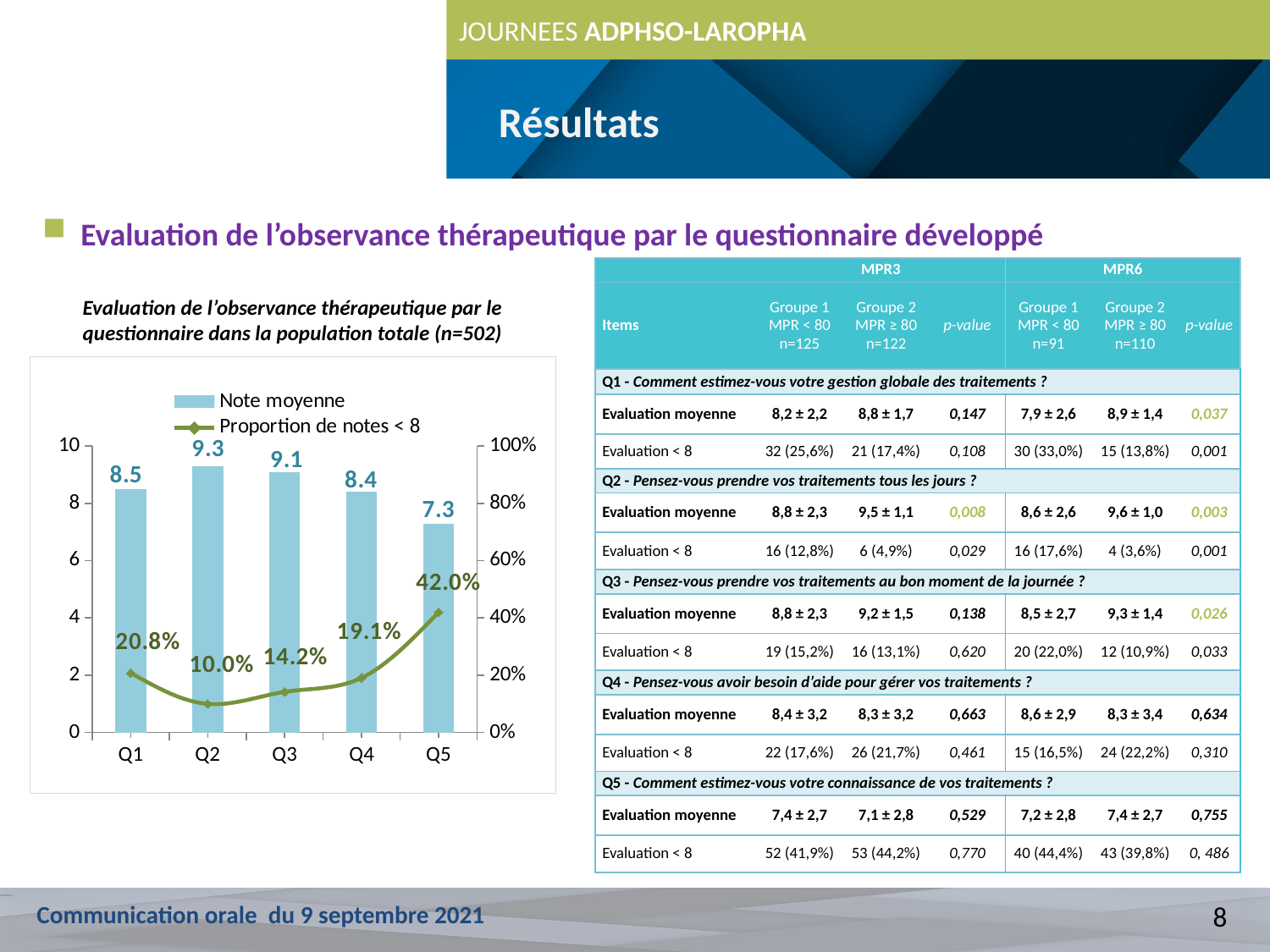
What is the Note moyenne value for Q4? 8.4 What is the difference between the Note moyenne for Q2 and for Q5? 2.0 Which category has the lowest Proportion de notes < 8? Q2 What is the Proportion de notes < 8 value for Q3? 14.2% How many categories are shown on the x axis of the chart? 5 Which category has the lowest Note moyenne? Q5 How many series does the chart legend list? 2 What is the Proportion de notes < 8 value for Q5? 42.0% Which is larger, the Proportion de notes < 8 for Q1 or for Q4? Q1 Does the Proportion de notes < 8 rise or fall from Q2 to Q5? rise Which category has the highest Note moyenne? Q2 What is the Note moyenne value for Q1? 8.5